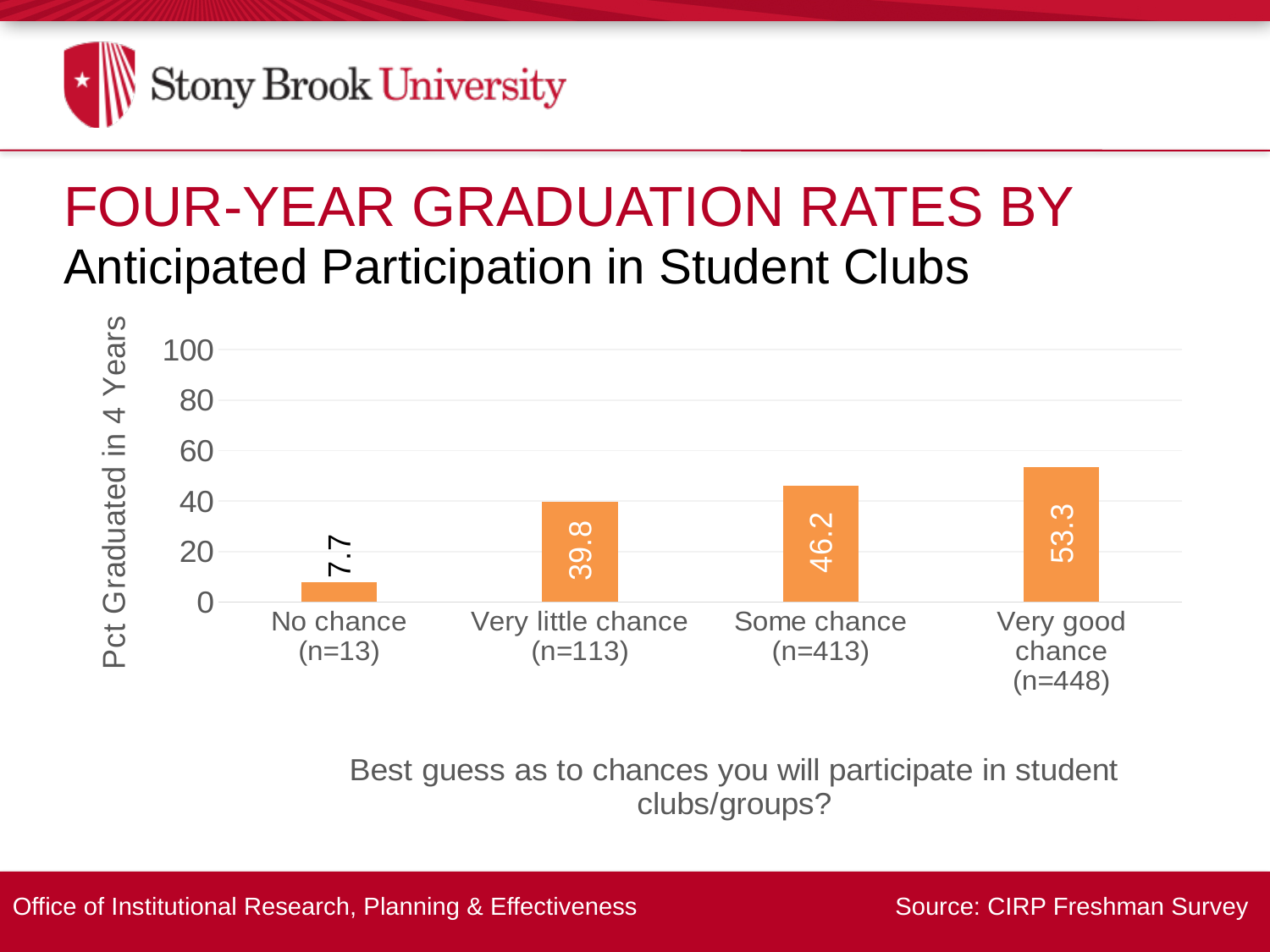
How many response categories are shown on the chart? 4 Do the graduation rates rise or fall as anticipated participation in student clubs increases from left to right? Rise What is the four-year graduation rate for the 'Very good chance' group? 53.3 What is the four-year graduation rate for students who said 'No chance' of participating in student clubs? 7.7 What is the four-year graduation rate for the 'Some chance' group? 46.2 Which response category has the highest four-year graduation rate? Very good chance What is the four-year graduation rate for the 'Very little chance' group? 39.8 Which group has a higher graduation rate, 'Some chance' or 'Very little chance'? Some chance What is the difference in graduation rate between the 'Some chance' and 'Very little chance' groups? 6.4 What is the difference in graduation rate between the 'Very good chance' and 'No chance' groups? 45.6 Which response category has the lowest four-year graduation rate? No chance What type of chart is shown on the slide? Bar chart